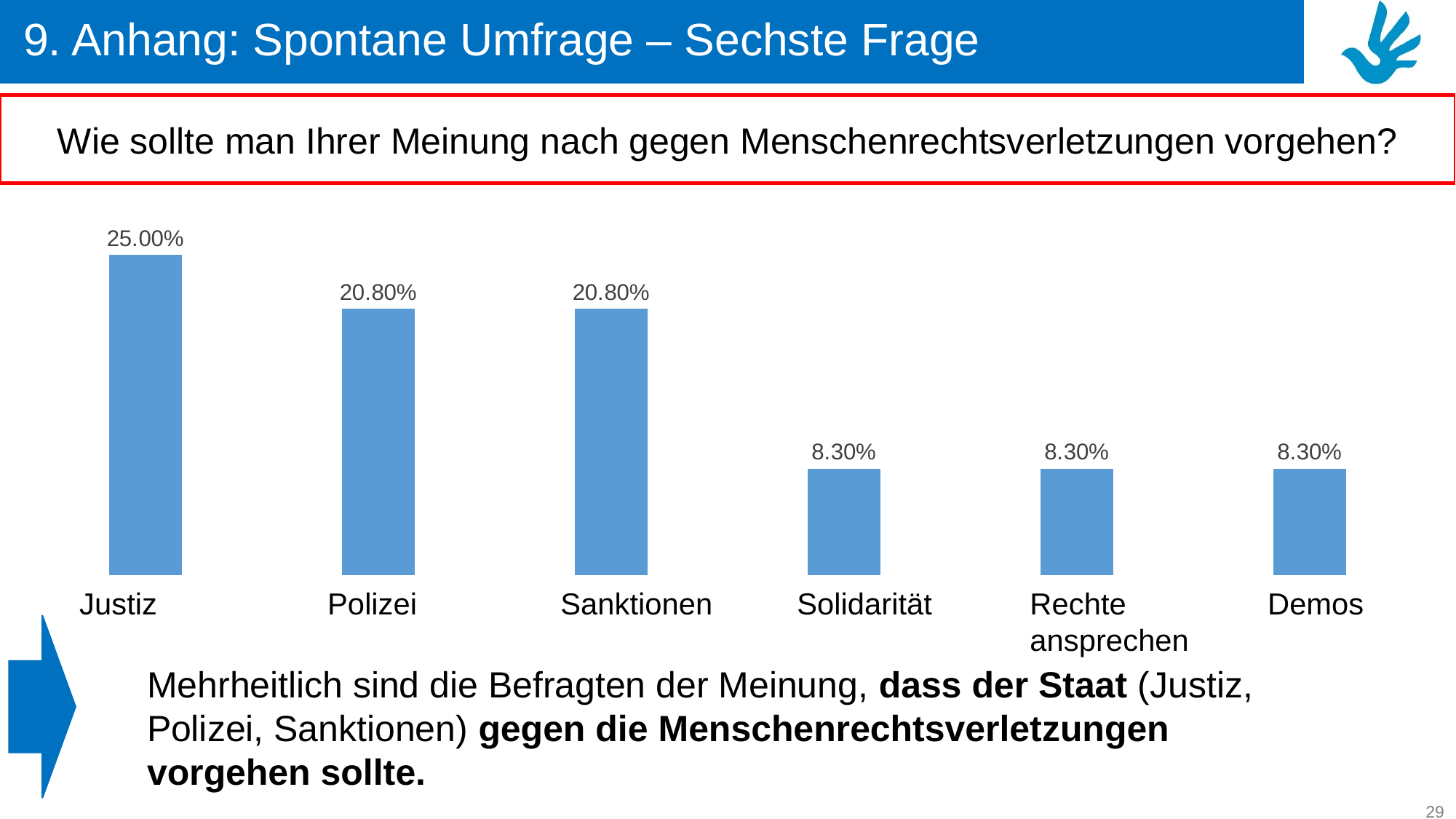
What is the value for Polizei? 20.80% What is the value for Solidarität? 8.30% Do the values rise or fall from left to right across the categories? Fall What is the value for Rechte ansprechen? 8.30% How many categories are shown in the chart? 6 What is the total of the values for Justiz, Polizei and Sanktionen? 66.60% Which is larger, the value for Sanktionen or the value for Solidarität? Sanktionen What kind of chart is shown on the slide? Bar chart What is the difference between the values for Justiz and Polizei? 4.20% Which category has the highest value? Justiz What is the value for Justiz? 25.00% What is the difference between the values for Sanktionen and Demos? 12.50%